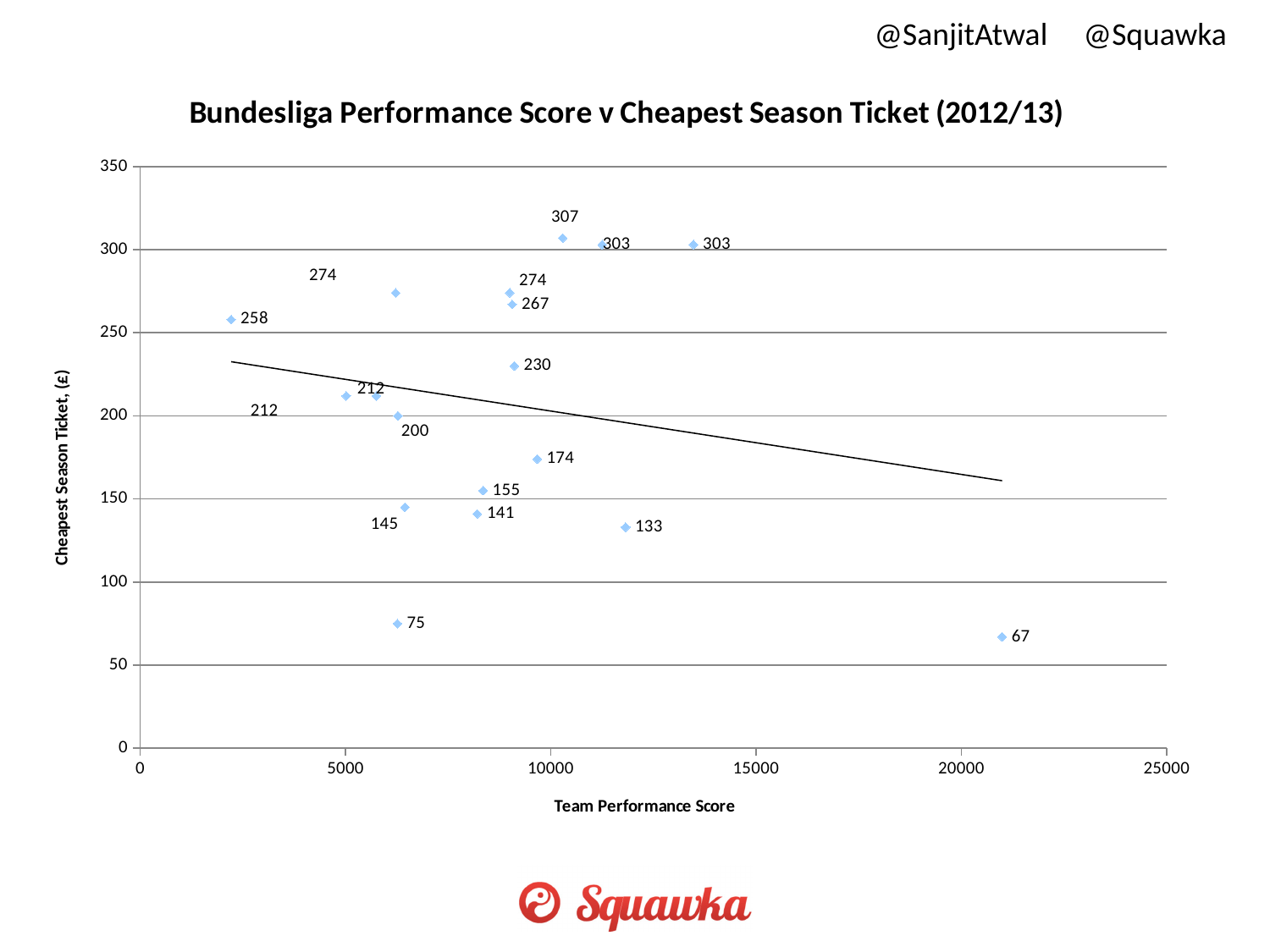
What is the label of the x axis? Team Performance Score Is the cheapest season ticket value for the point with the highest Team Performance Score greater or less than 100? less What is the title of the chart? Bundesliga Performance Score v Cheapest Season Ticket (2012/13) Does the trend line rise or fall as Team Performance Score increases? falls How many data points are plotted on the chart? 18 What is the lowest cheapest season ticket value plotted on the chart? 67 What is the highest cheapest season ticket value plotted on the chart? 307 What is the difference between the highest and lowest cheapest season ticket values plotted? 240 How many points on the chart are labelled 303? 2 Which is larger, the cheapest season ticket value labelled 230 or the one labelled 174? 230 Is the cheapest season ticket value for the point with the lowest Team Performance Score greater or less than 250? greater What kind of chart is shown on the slide? scatter chart